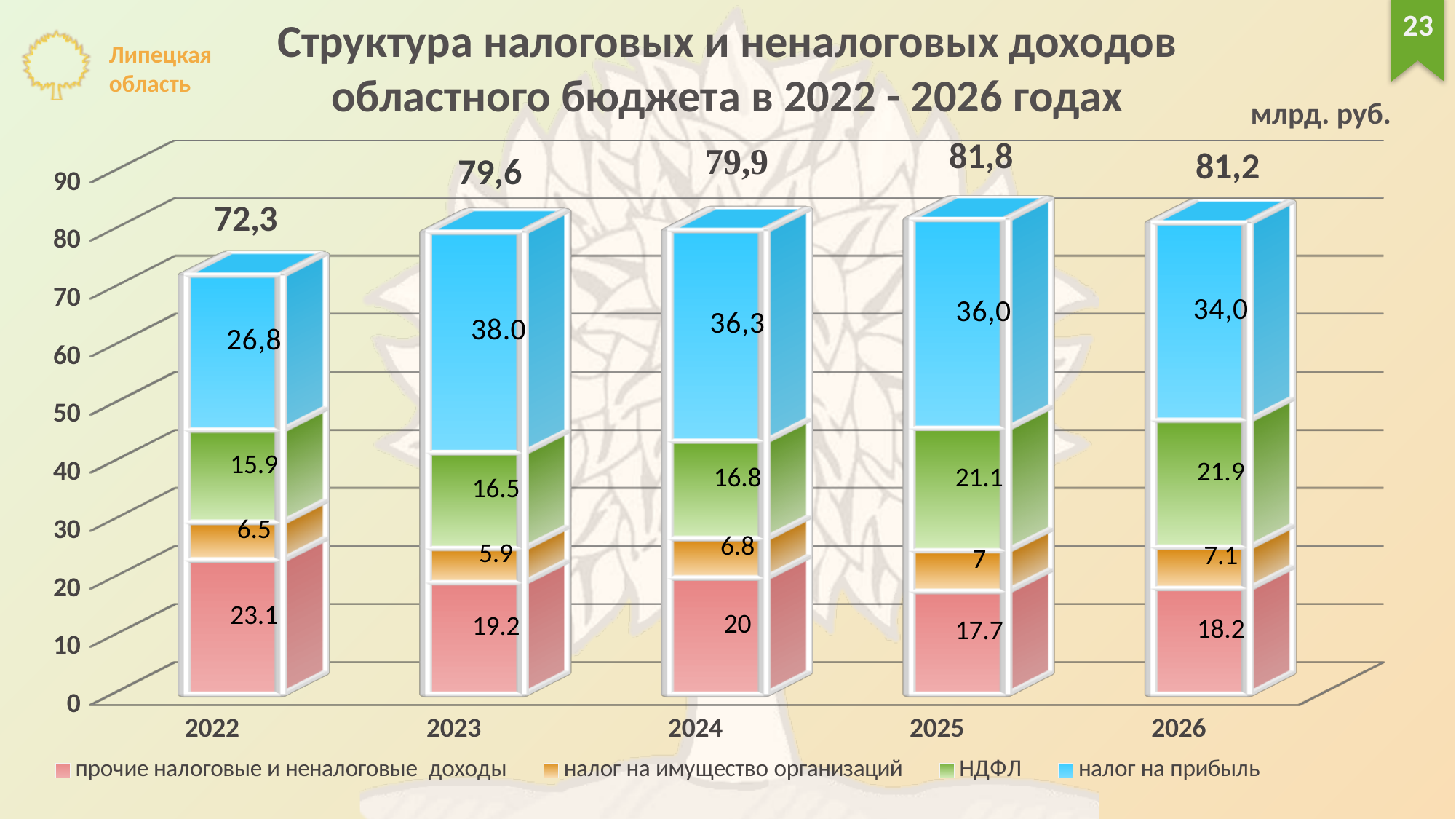
What kind of chart is shown on the slide? stacked bar chart What is the value of НДФЛ for 2025? 21.1 Which year has the highest total? 2025 What is the difference between прочие налоговые и неналоговые доходы in 2022 and in 2023? 3.9 What is the total of the stacked bar for 2025? 81,8 What is the value of налог на прибыль for 2023? 38.0 Which year has the lowest total? 2022 What is the value of налог на имущество организаций for 2024? 6.8 How many years (categories) are shown on the x axis? 5 How many series does the legend list? 4 What is the value of прочие налоговые и неналоговые доходы for 2022? 23.1 Which is larger, налог на прибыль in 2024 or in 2026? 2024